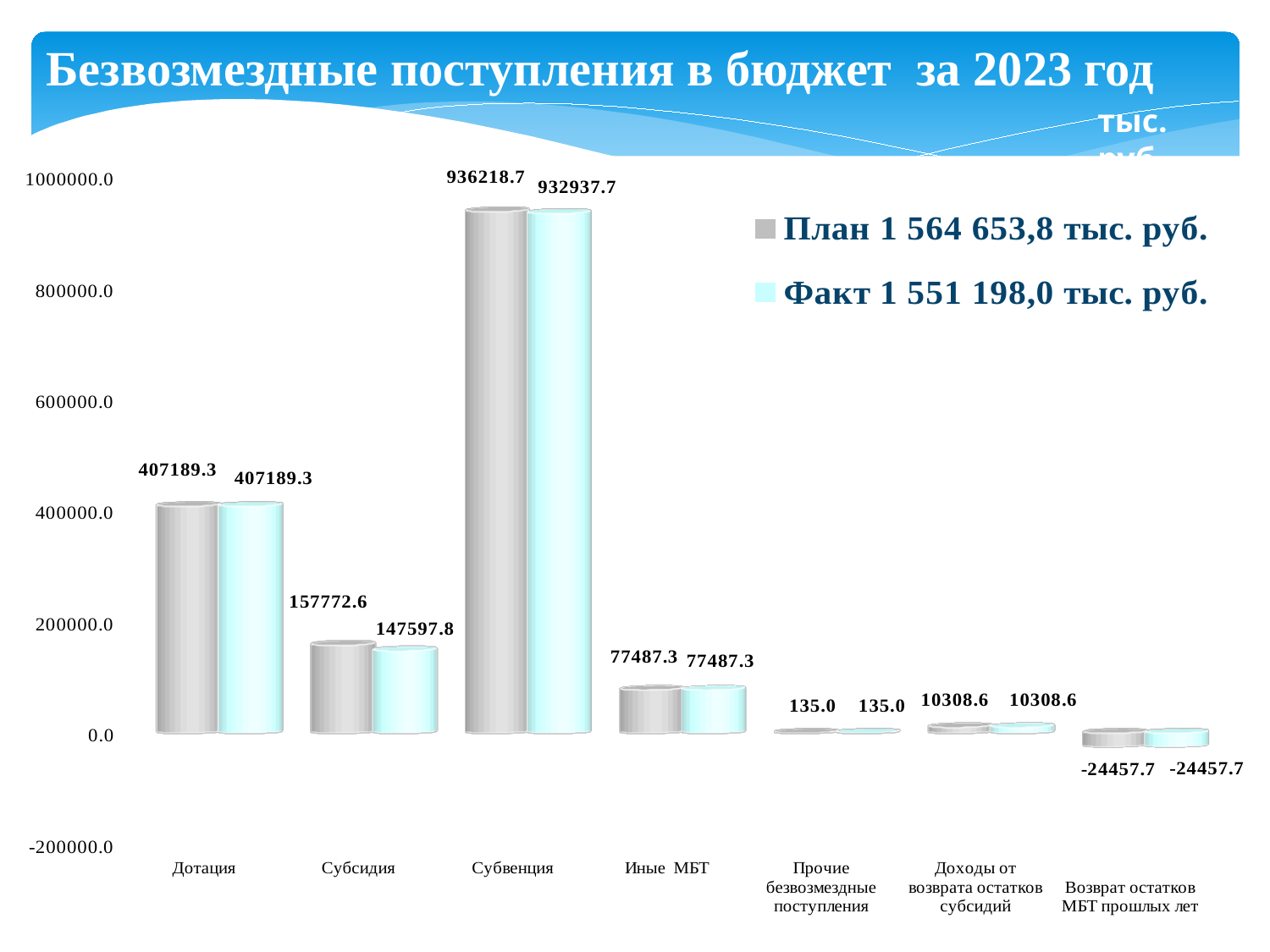
What is the difference between the План and Факт values for Субсидия? 10174.8 Which category has the highest План value? Субвенция How many categories are shown on the x axis? 7 What is the План value for Возврат остатков МБТ прошлых лет? -24457.7 What is the difference between the План and Факт values for Субвенция? 3281.0 What is the План value for Субвенция? 936218.7 What is the Факт value for Дотация? 407189.3 How many series does the legend list? 2 Which category has the lowest Факт value? Возврат остатков МБТ прошлых лет What is the Факт value for Субсидия? 147597.8 Which is larger, the Факт value for Иные МБТ or the Факт value for Доходы от возврата остатков субсидий? Иные МБТ What kind of chart is shown on the slide? bar chart